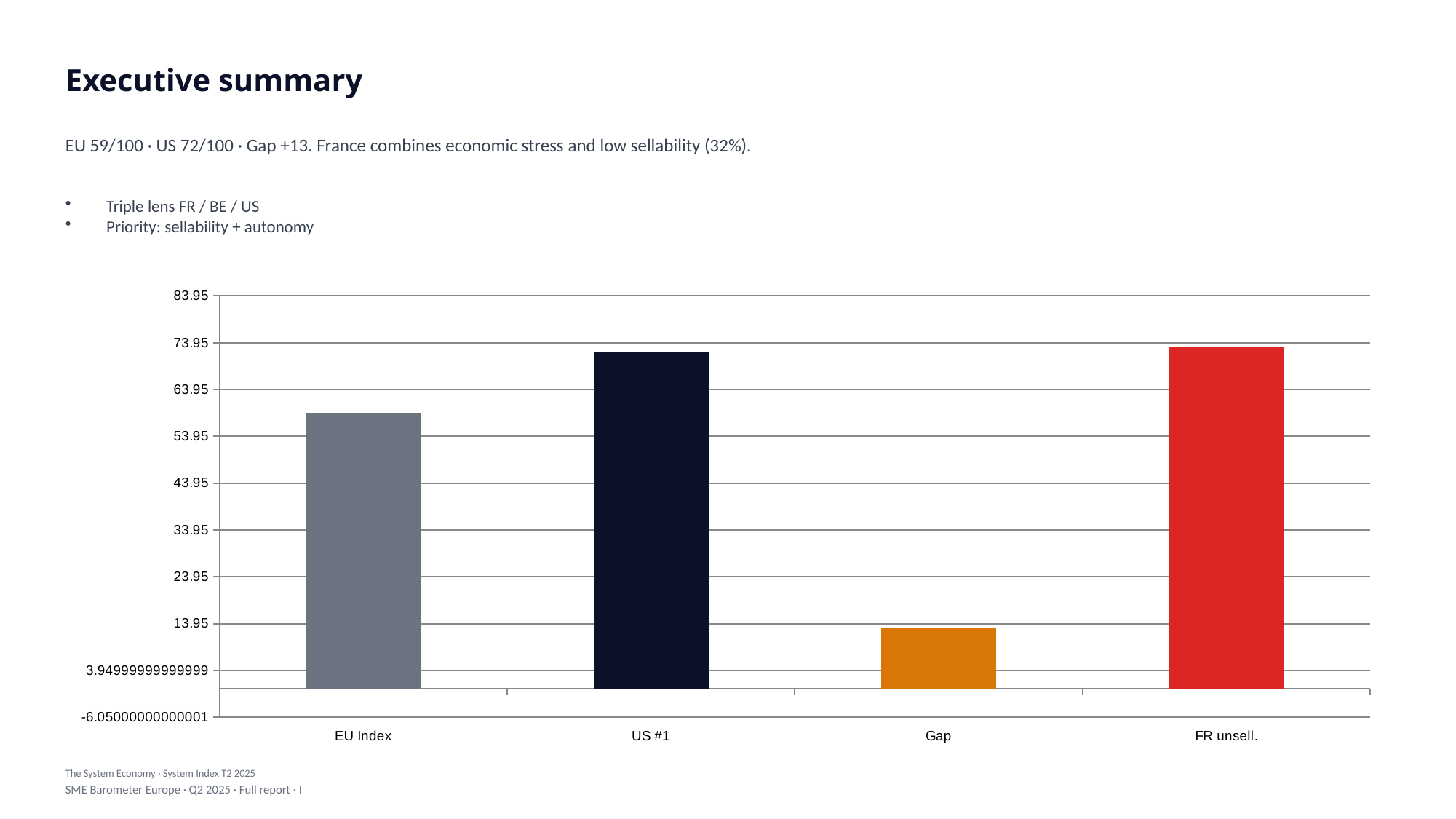
What kind of chart is shown on the slide? bar chart Is the value for EU Index greater or less than 63.95? less Which is larger, the bar for EU Index or the bar for US #1? US #1 Which is larger, the bar for Gap or the bar for FR unsell.? FR unsell. Which category has the lowest bar in the chart? Gap Is the value for US #1 greater or less than 63.95? greater What colour is the bar for FR unsell.? red Is the value for FR unsell. greater or less than 53.95? greater How many categories are plotted in the chart? 4 What is the label of the third category on the x axis? Gap Which is larger, the bar for Gap or the bar for EU Index? EU Index